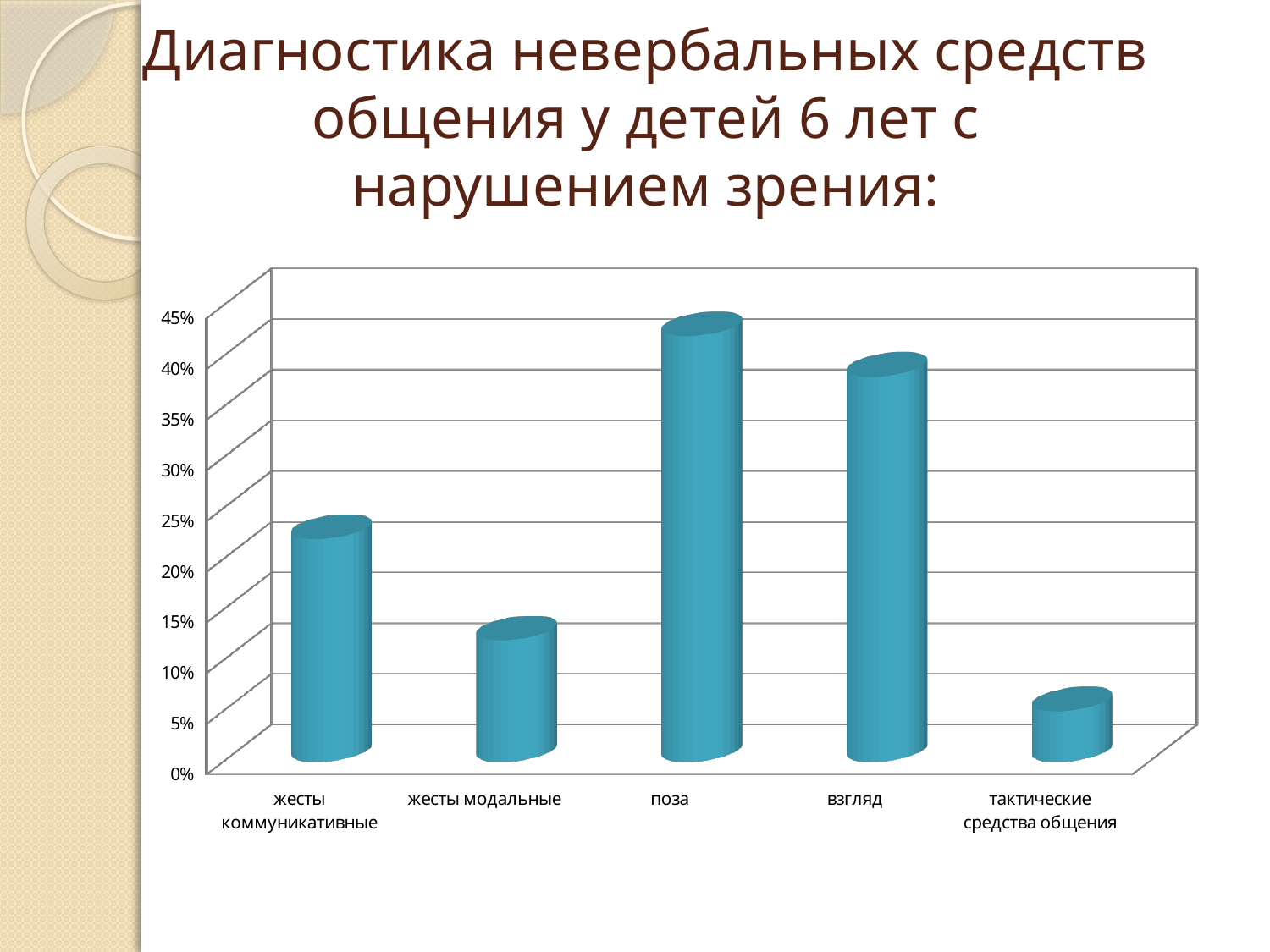
Which category has the highest value in the chart? поза Is the value for жесты коммуникативные greater or less than 20%? greater Is the value for тактические средства общения greater or less than 10%? less How many categories are shown on the x axis of the chart? 5 What is the title of the slide containing the chart? Диагностика невербальных средств общения у детей 6 лет с нарушением зрения: Is the value for поза greater or less than 40%? greater Which is larger, the value for поза or the value for взгляд? поза What kind of chart is shown on the slide? bar chart Which category has the lowest value in the chart? тактические средства общения Which is larger, the value for жесты коммуникативные or the value for жесты модальные? жесты коммуникативные